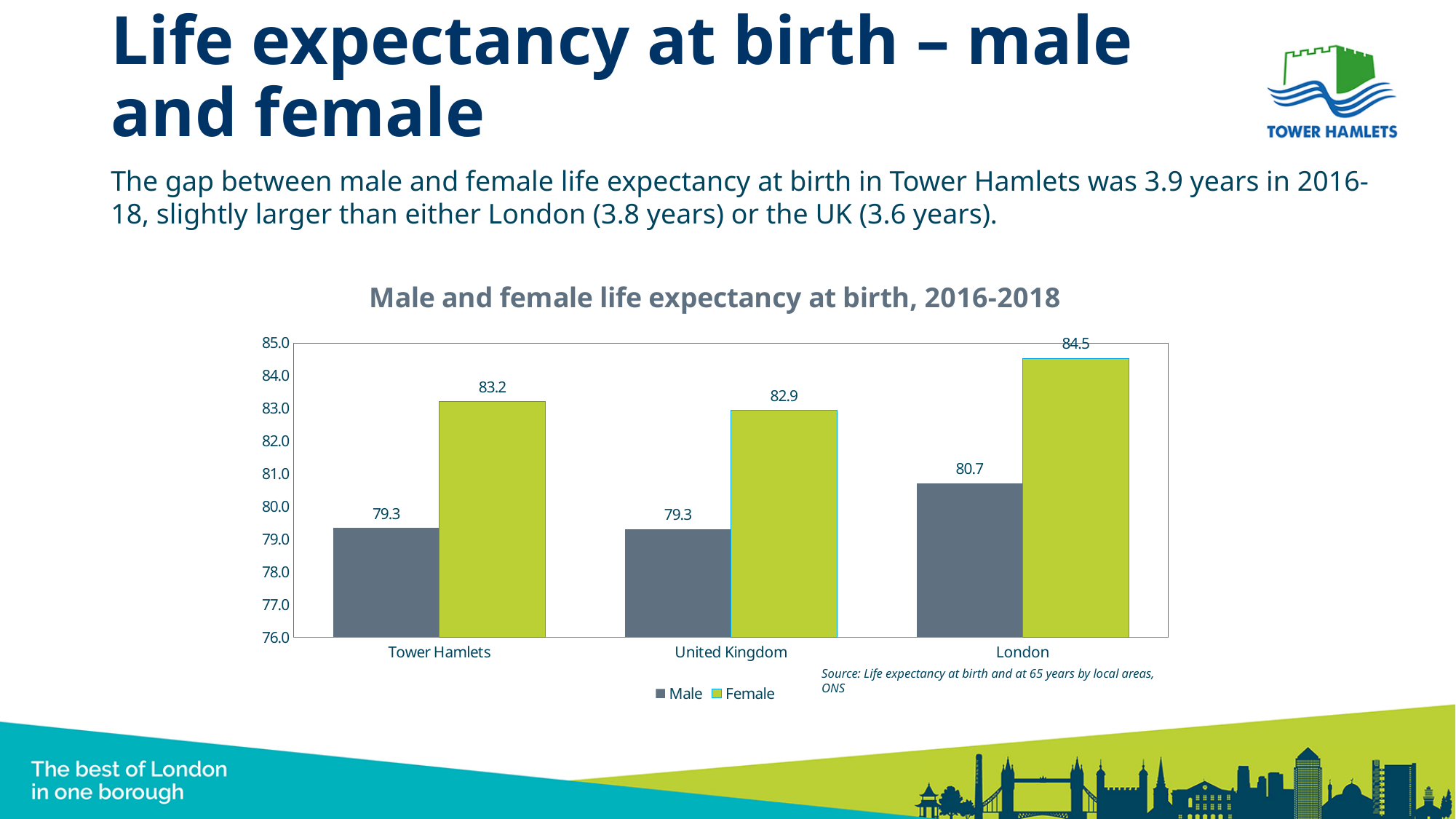
Is the male life expectancy at birth for London greater or less than 80.0? greater Which area has the lowest female life expectancy at birth? United Kingdom How many areas are shown on the x axis of the chart? 3 How many series does the chart legend list? 2 What is the difference between female and male life expectancy at birth in Tower Hamlets? 3.9 What is the female life expectancy at birth for the United Kingdom? 82.9 Is the female life expectancy at birth higher in Tower Hamlets or in the United Kingdom? Tower Hamlets Which area has the highest male life expectancy at birth? London What type of chart is shown on the slide? Bar chart What is the difference between female life expectancy in London and in Tower Hamlets? 1.3 What is the female life expectancy at birth for London? 84.5 What is the male life expectancy at birth for Tower Hamlets? 79.3